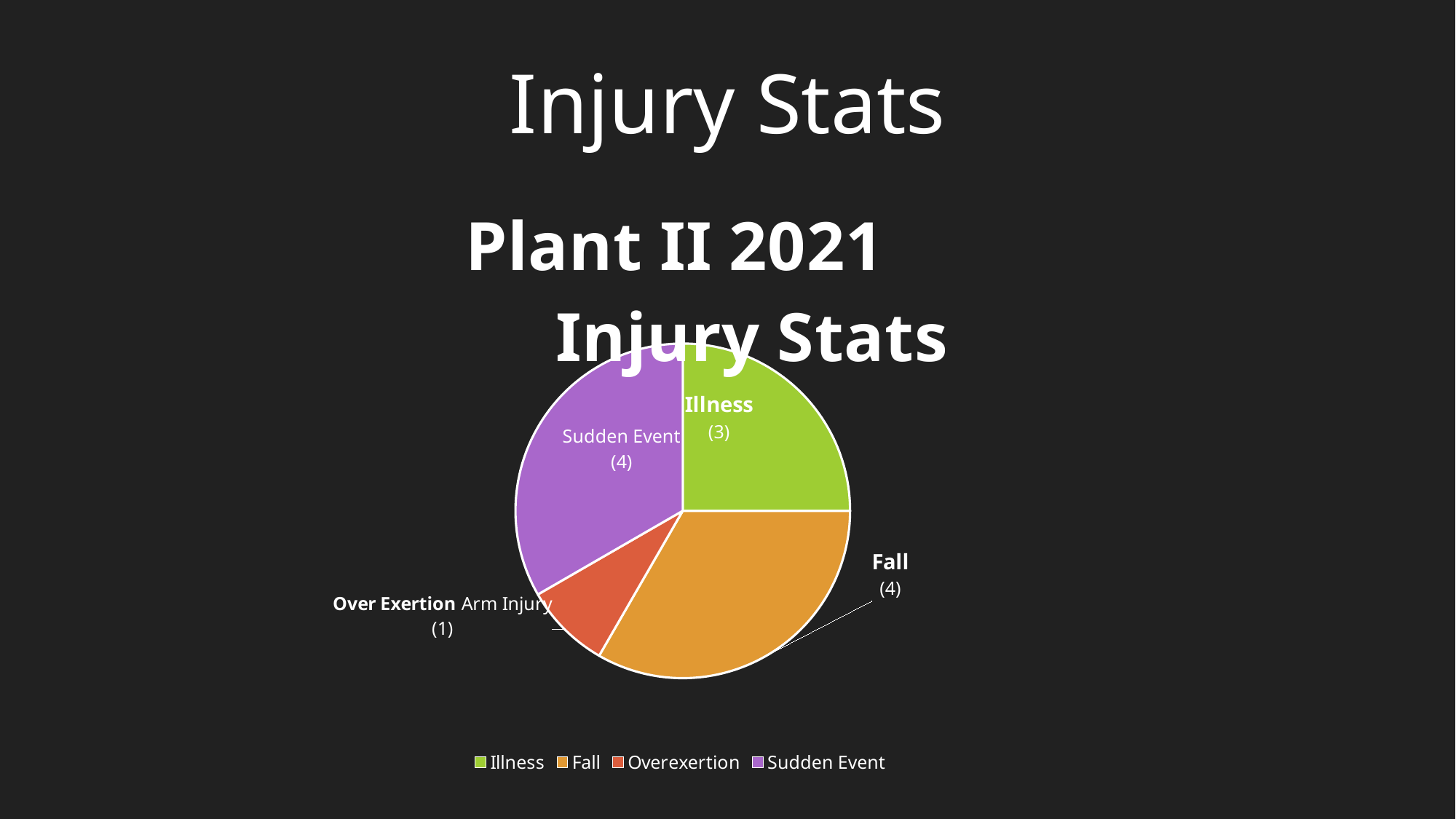
Which category has the smallest slice in the pie chart? Overexertion What is the value for Illness in the pie chart? 3 What kind of chart is shown on the slide? Pie chart How many categories are shown in the pie chart? 4 What is the title of the chart? Plant II 2021 Injury Stats What is the value for Fall in the pie chart? 4 What is the difference between the value for Fall and the value for Illness? 1 What is the value for Sudden Event in the pie chart? 4 What share of the pie does the Illness slice represent? 25% Which is larger, the value for Fall or the value for Illness? Fall What is the value for Over Exertion (Arm Injury) in the pie chart? 1 What is the difference between the value for Sudden Event and the value for Over Exertion? 3